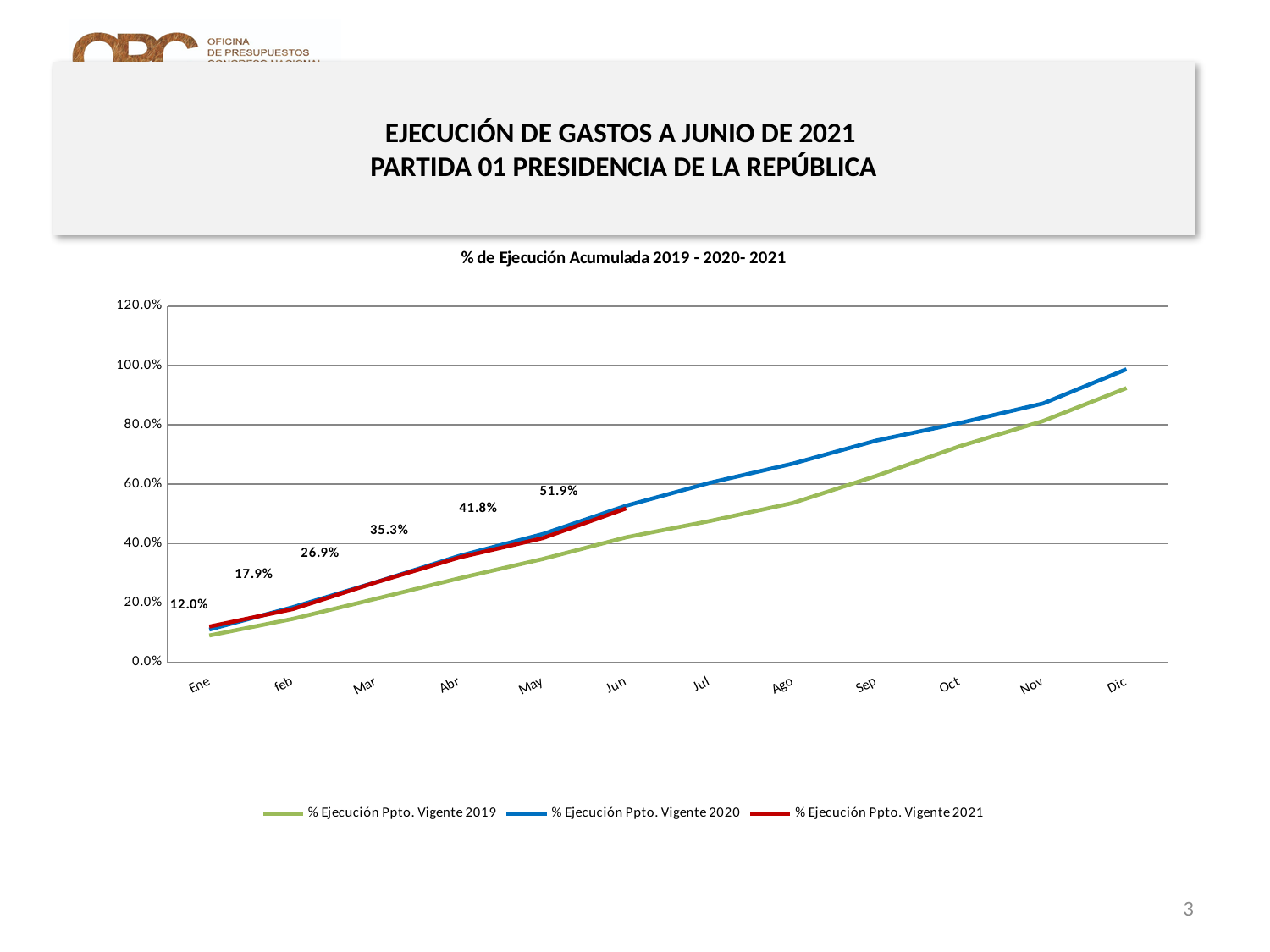
By how many percentage points did % Ejecución Ppto. Vigente 2021 increase from May to Jun? 10.1 percentage points Do the values of % Ejecución Ppto. Vigente 2020 rise or fall from Ene to Dic? Rise How many months are shown on the x axis? 12 How many series does the legend list? 3 Which month has the highest labelled value for % Ejecución Ppto. Vigente 2021? Jun What is the title of the chart? % de Ejecución Acumulada 2019 - 2020- 2021 What is the value of % Ejecución Ppto. Vigente 2021 for Ene? 12.0% What kind of chart is shown on the slide? Line chart Is the value for % Ejecución Ppto. Vigente 2020 in Dic greater or less than 80.0%? greater In Dic, which series is higher: % Ejecución Ppto. Vigente 2019 or % Ejecución Ppto. Vigente 2020? % Ejecución Ppto. Vigente 2020 What is the value of % Ejecución Ppto. Vigente 2021 for Jun? 51.9% What is the value of % Ejecución Ppto. Vigente 2021 for Abr? 35.3%